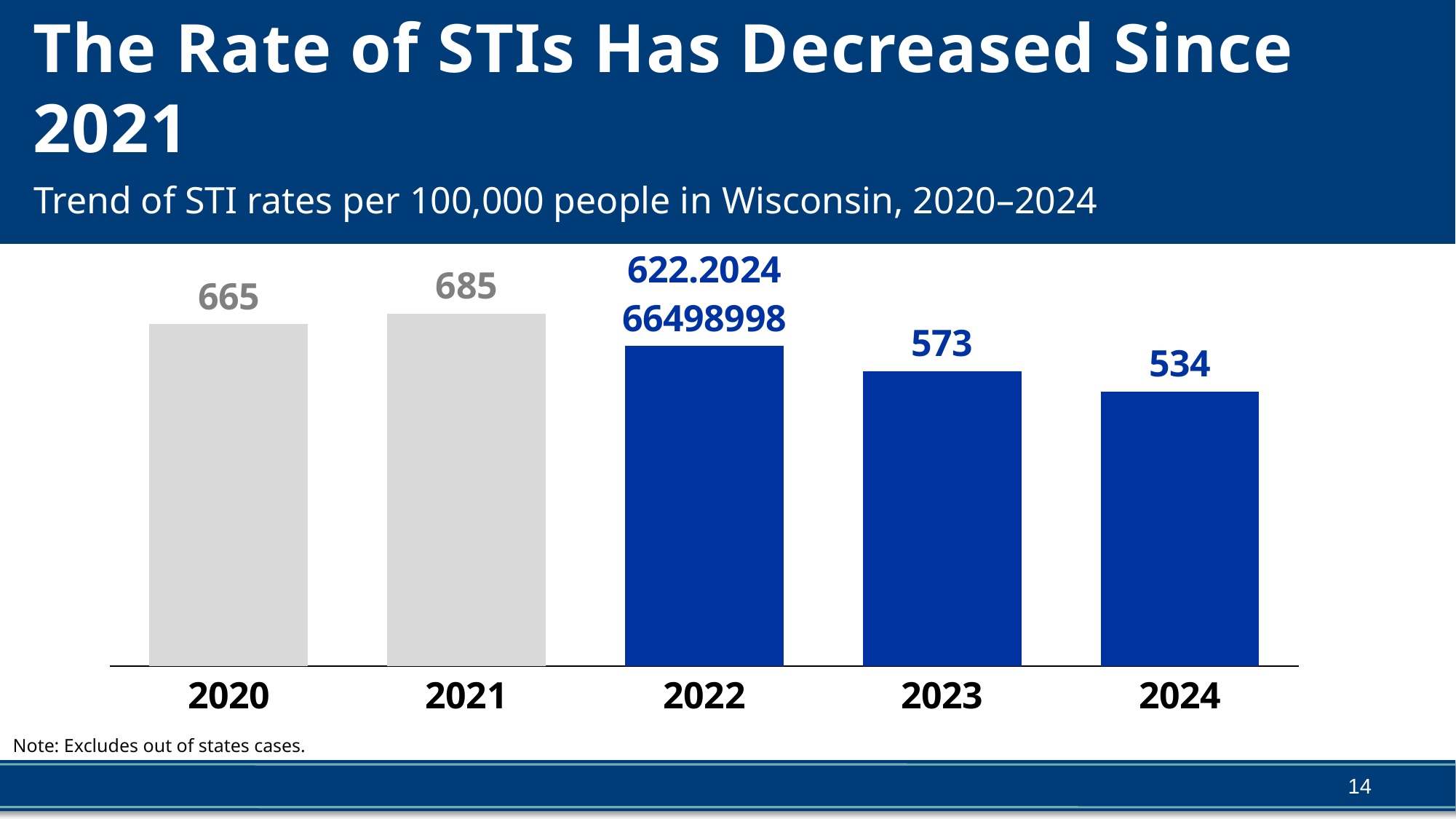
What is the STI rate per 100,000 people in Wisconsin for 2020? 665 Which year has the lowest STI rate on the chart? 2024 Do the STI rates rise or fall from 2021 to 2024? Fall How many years are shown on the chart? 5 What is the STI rate per 100,000 people in Wisconsin for 2023? 573 What kind of chart is shown on the slide? Bar chart What is the STI rate per 100,000 people in Wisconsin for 2024? 534 What is the difference between the STI rates for 2020 and 2021? 20 What is the difference between the STI rates for 2021 and 2024? 151 What is the STI rate per 100,000 people in Wisconsin for 2021? 685 Which year has a higher STI rate, 2022 or 2023? 2022 Which year has the highest STI rate on the chart? 2021